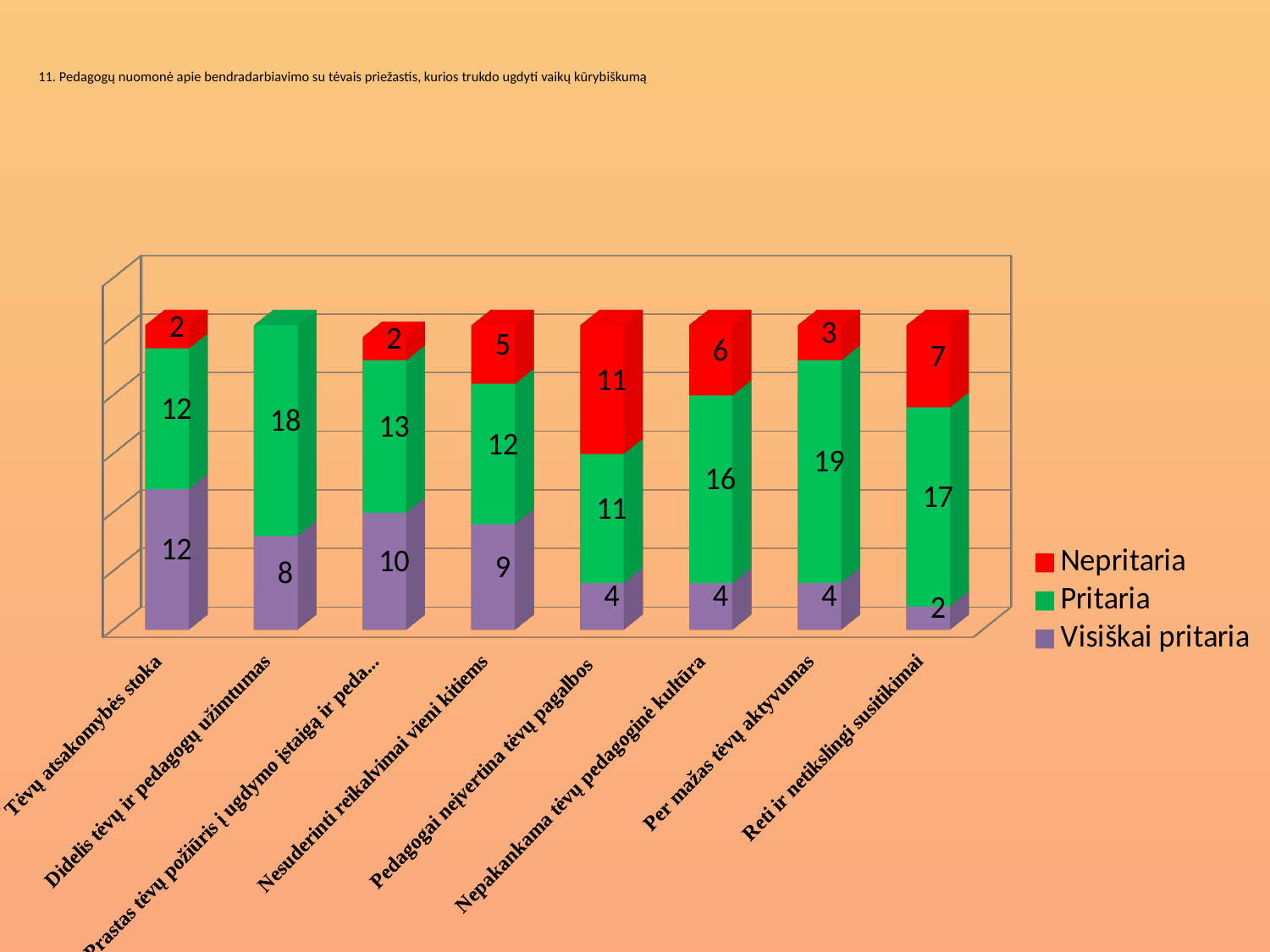
What is the Visiškai pritaria value for Tėvų atsakomybės stoka? 12 What is the Pritaria value for Per mažas tėvų aktyvumas? 19 Which category has the lowest Visiškai pritaria value? Reti ir netikslingi susitikimai What kind of chart is shown on the slide? Stacked bar chart How many categories are shown on the x axis? 8 Which has the larger Visiškai pritaria value: Didelis tėvų ir pedagogų užimtumas or Nesuderinti reikalvimai vieni kitiems? Nesuderinti reikalvimai vieni kitiems What is the total of the stacked bar for Reti ir netikslingi susitikimai? 26 What is the difference between the Pritaria values for Didelis tėvų ir pedagogų užimtumas and Nesuderinti reikalvimai vieni kitiems? 6 How many series does the legend list? 3 Which category has the highest Nepritaria value? Pedagogai neįvertina tėvų pagalbos What is the Nepritaria value for Pedagogai neįvertina tėvų pagalbos? 11 Which category has the highest Pritaria value? Per mažas tėvų aktyvumas